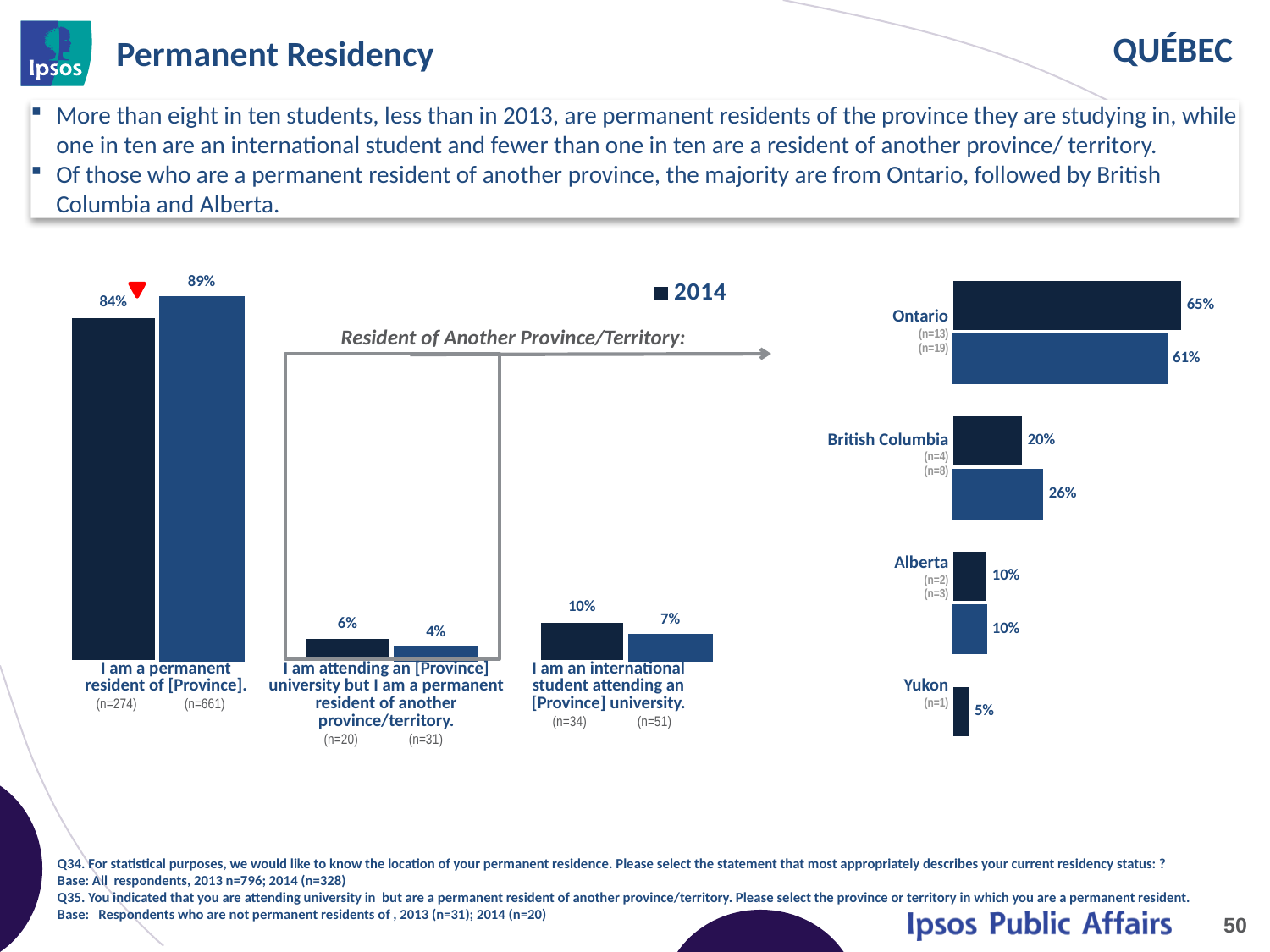
On the left chart, what is the 2014 value for "I am attending an [Province] university but I am a permanent resident of another province/territory"? 6% On the left chart, what is the 2014 value for "I am a permanent resident of [Province]"? 84% On the left chart, which category has the highest 2014 value? I am a permanent resident of [Province]. On the right chart (Resident of Another Province/Territory), what is the 2014 (dark blue) value for Ontario? 65% How many categories are shown on the left chart? 3 On the right chart (Resident of Another Province/Territory), what is the lighter blue bar value for British Columbia? 26% What type of chart is used on the left side of the slide? Bar chart On the left chart, what is the 2014 value for "I am an international student attending an [Province] university"? 10% On the left chart, what is the difference between the two bars for "I am a permanent resident of [Province]" (84% and 89%)? 5 percentage points On the right chart (Resident of Another Province/Territory), which province or territory has the lowest value? Yukon On the right chart, what is the difference between the two Ontario bars (65% and 61%)? 4 percentage points How many provinces/territories are listed on the right chart (Resident of Another Province/Territory)? 4